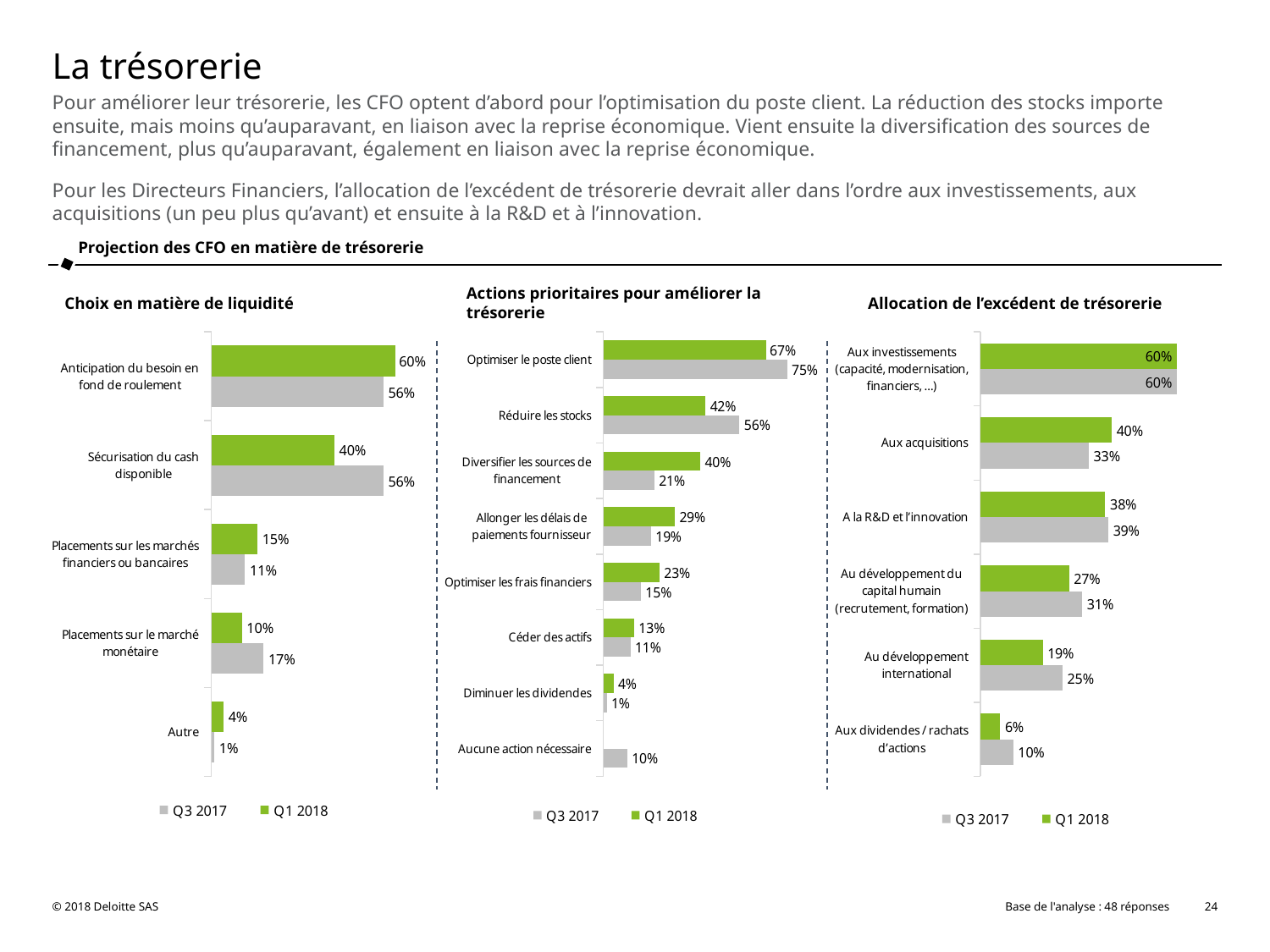
In the chart 'Allocation de l'excédent de trésorerie', which is larger for 'Au développement international': the Q3 2017 value or the Q1 2018 value? Q3 2017 In the chart 'Choix en matière de liquidité', what is the Q1 2018 value for 'Sécurisation du cash disponible'? 40% In the chart 'Allocation de l'excédent de trésorerie', what is the Q1 2018 value for 'Aux acquisitions'? 40% In the chart 'Allocation de l'excédent de trésorerie', what is the Q3 2017 value for 'Aux dividendes / rachats d'actions'? 10% What type of chart is 'Allocation de l'excédent de trésorerie'? Bar chart In the chart 'Choix en matière de liquidité', how many categories are shown? 5 In the chart 'Actions prioritaires pour améliorer la trésorerie', how many series does the legend list? 2 In the chart 'Actions prioritaires pour améliorer la trésorerie', what is the difference between the Q1 2018 and Q3 2017 values for 'Diversifier les sources de financement'? 19 percentage points In the chart 'Choix en matière de liquidité', what is the Q3 2017 value for 'Placements sur le marché monétaire'? 17% In the chart 'Choix en matière de liquidité', which category has the highest Q1 2018 value? Anticipation du besoin en fond de roulement In the chart 'Actions prioritaires pour améliorer la trésorerie', what is the Q3 2017 value for 'Optimiser le poste client'? 75% In the chart 'Actions prioritaires pour améliorer la trésorerie', which category has the lowest Q3 2017 value? Diminuer les dividendes